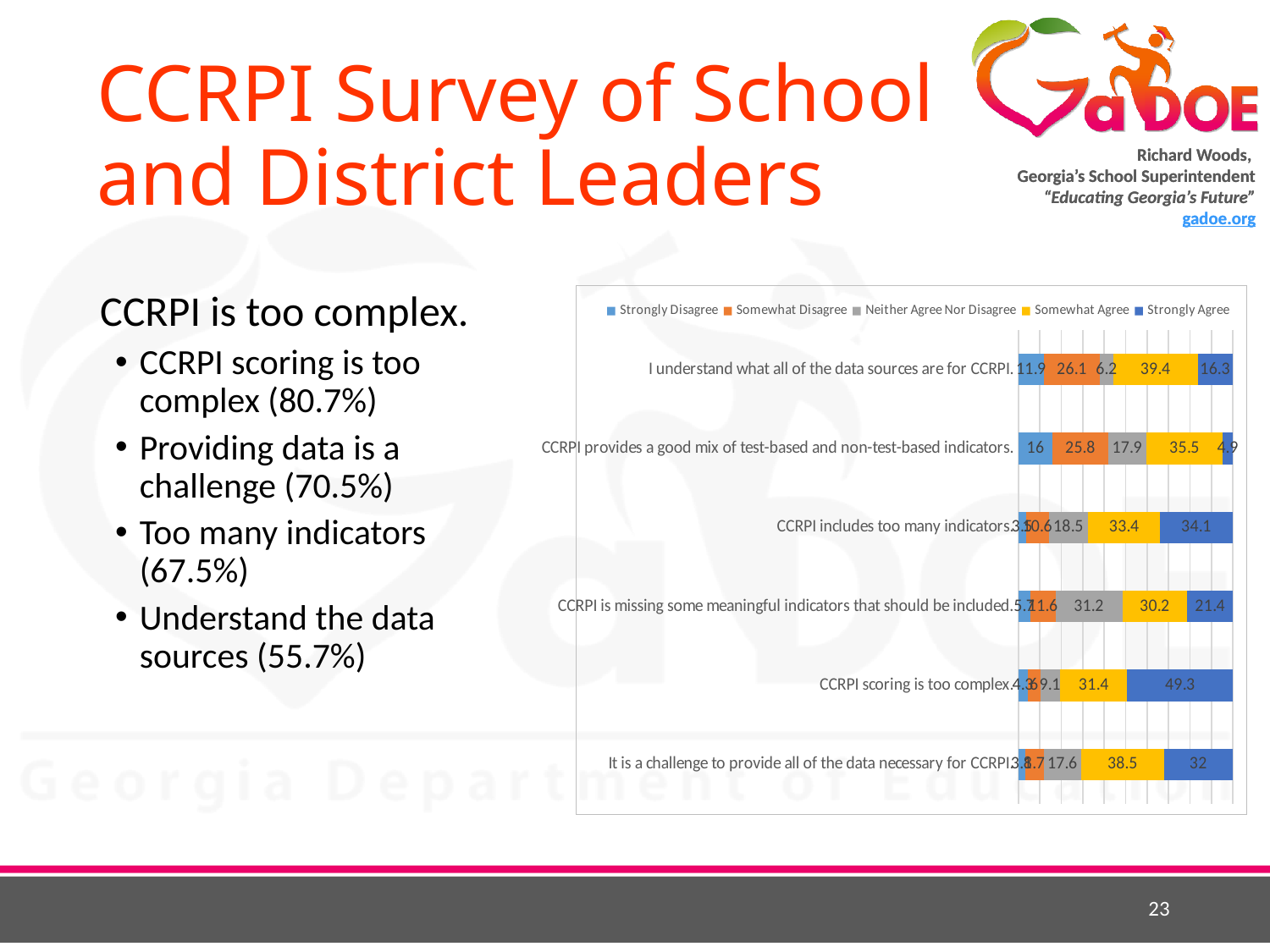
Which statement has the highest Strongly Agree value? CCRPI scoring is too complex. What is the Somewhat Agree value for "I understand what all of the data sources are for CCRPI"? 39.4 How many series does the chart legend list? 5 What kind of chart is shown on the slide? Stacked bar chart What is the difference between the Strongly Agree values for "CCRPI includes too many indicators" (34.1) and "It is a challenge to provide all of the data necessary for CCRPI" (32)? 2.1 What is the Strongly Disagree value for "CCRPI provides a good mix of test-based and non-test-based indicators"? 16 Which has the larger Somewhat Agree value: "It is a challenge to provide all of the data necessary for CCRPI" or "CCRPI includes too many indicators"? It is a challenge to provide all of the data necessary for CCRPI What is the Neither Agree Nor Disagree value for "CCRPI is missing some meaningful indicators that should be included"? 31.2 How many statements (categories) are plotted in the chart? 6 Which statement has the lowest Strongly Agree value? CCRPI provides a good mix of test-based and non-test-based indicators. What is the Strongly Agree value for "CCRPI scoring is too complex"? 49.3 What is the first entry listed in the chart legend? Strongly Disagree